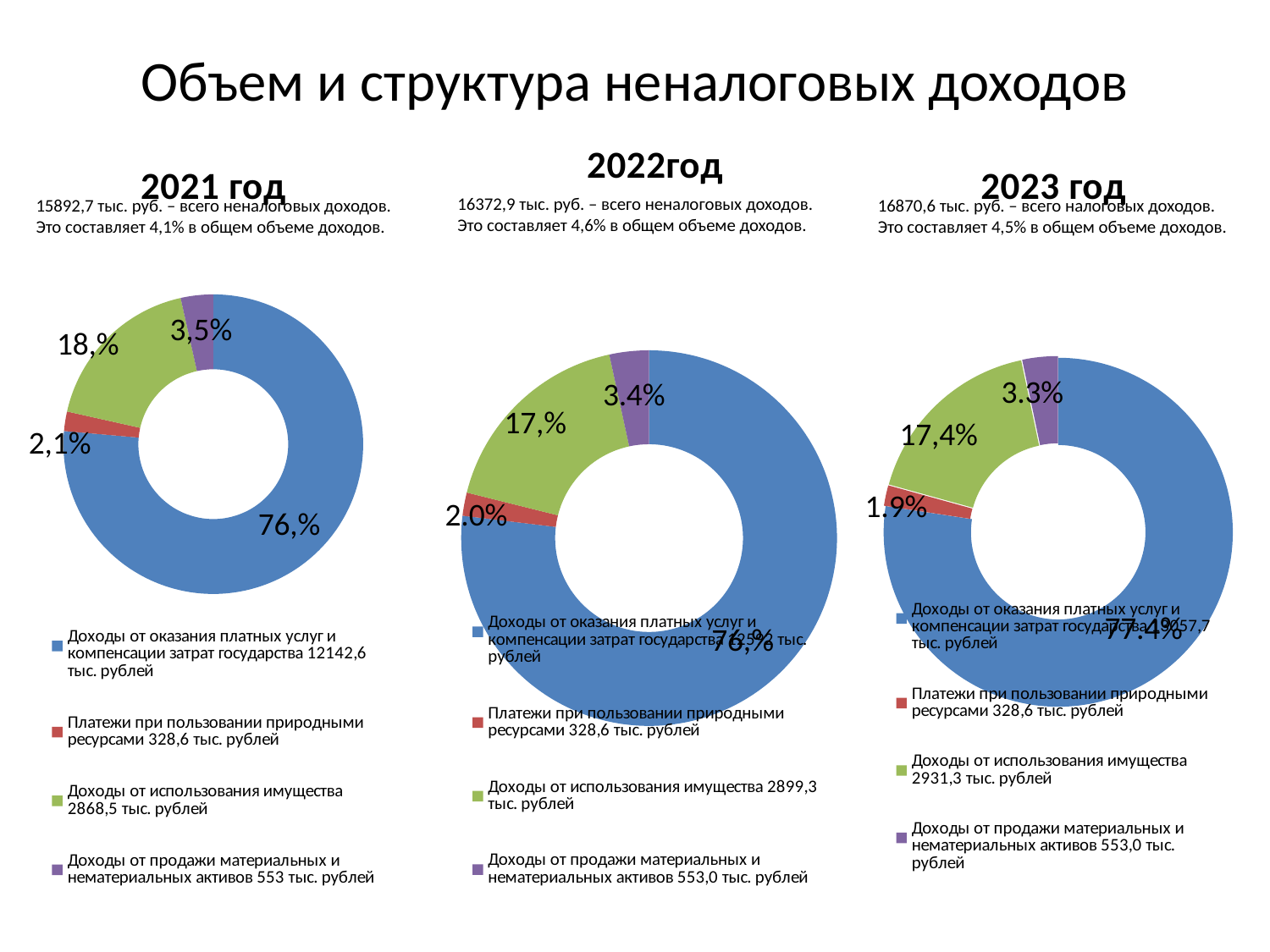
In the 2022год chart, what percentage is shown for Доходы от использования имущества? 17,% In the 2023 год chart, which category has the smallest slice? Платежи при пользовании природными ресурсами In the 2021 год chart, what percentage is shown for Платежи при пользовании природными ресурсами? 2,1% What type of chart is used for the 2022год data? Doughnut (pie) chart In the 2021 год chart, what percentage is shown for Доходы от продажи материальных и нематериальных активов? 3,5% In the 2023 год chart, what percentage is shown for Доходы от использования имущества? 17,4% How many categories does the legend of the 2023 год chart list? 4 In the 2021 год chart, what share is shown for the largest slice (Доходы от оказания платных услуг и компенсации затрат государства)? 76,% In the 2021 год chart, which category has the largest slice? Доходы от оказания платных услуг и компенсации затрат государства In the 2023 год chart, is the slice for Доходы от продажи материальных и нематериальных активов (3.3%) larger or smaller than the slice for Платежи при пользовании природными ресурсами (1.9%)? larger In the 2022год chart, what percentage is shown for Платежи при пользовании природными ресурсами? 2.0% In the 2023 год chart, what percentage is shown for Доходы от оказания платных услуг и компенсации затрат государства? 77.4%